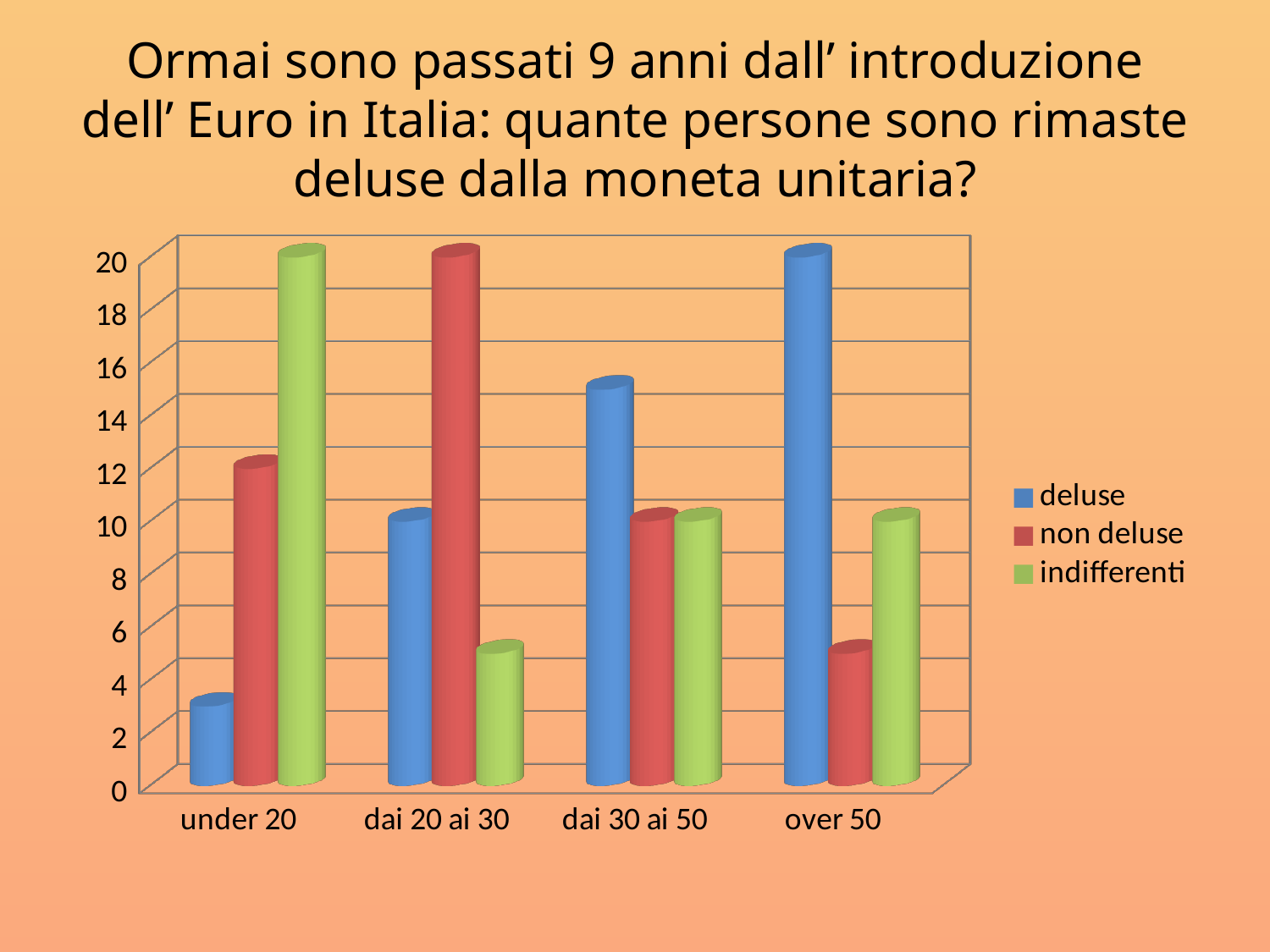
Which age category has the highest value for deluse? over 50 What is the value for deluse in the over 50 category? 20 How many series does the legend list? 3 What is the value for indifferenti in the under 20 category? 20 Which age category has the lowest value for non deluse? over 50 Is the value for deluse in the under 20 category greater or less than 4? less What is the value for non deluse in the dai 20 ai 30 category? 20 Is the value for indifferenti in the dai 20 ai 30 category greater or less than 8? less Is the value for deluse in the dai 30 ai 50 category greater or less than 12? greater In the under 20 category, which is larger: deluse or non deluse? non deluse How many age categories are shown on the x axis? 4 What kind of chart is shown on the slide? bar chart